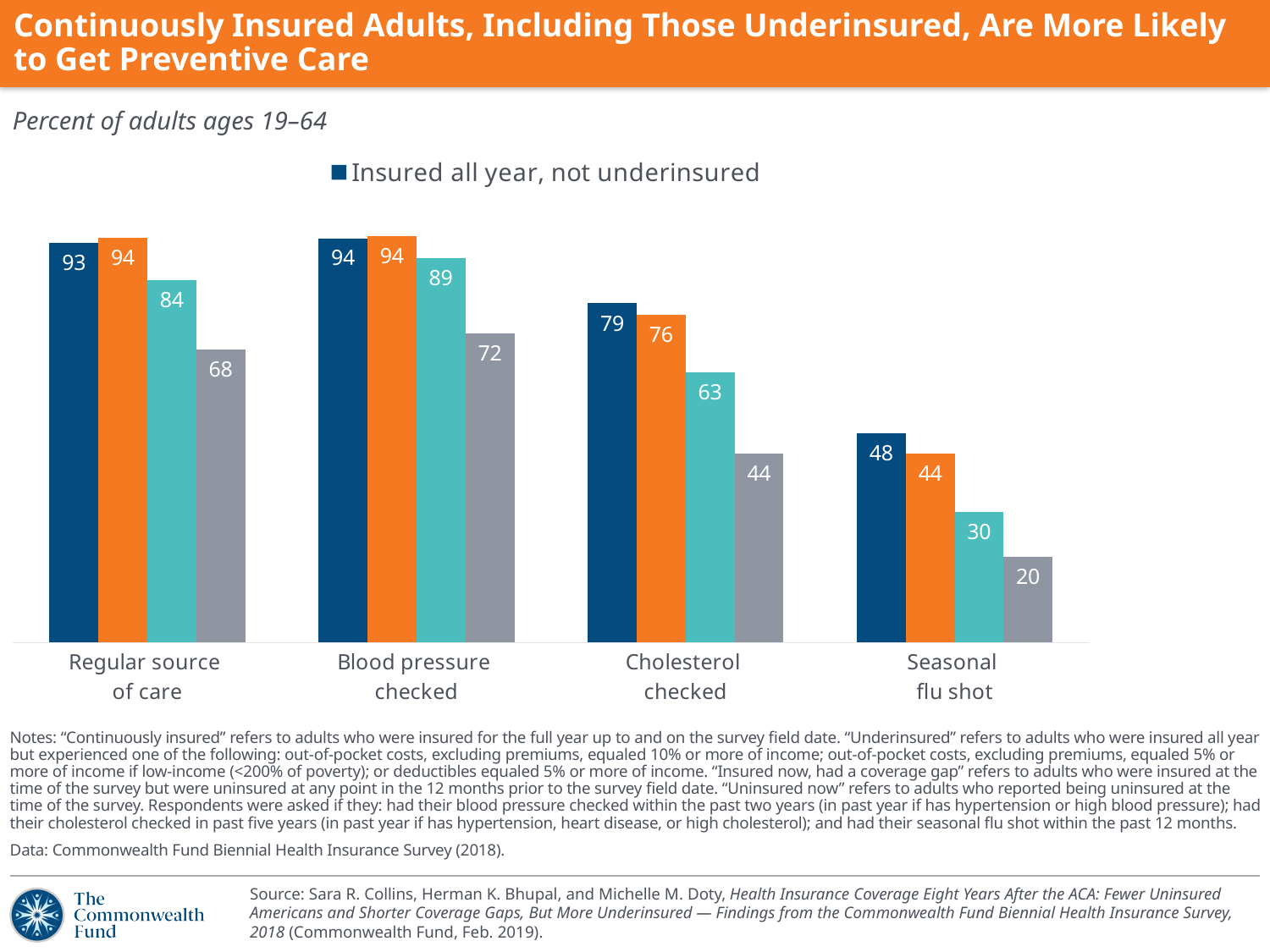
What is the value for 'Insured all year, not underinsured' adults for Seasonal flu shot? 48 What is the value of the gray bar for Cholesterol checked? 44 What is the difference between the 'Insured all year, not underinsured' value and the gray bar value for Seasonal flu shot? 28 How many series does the legend list? 1 What is the value for 'Insured all year, not underinsured' adults for Regular source of care? 93 What is the difference between the orange bar and the teal bar for Cholesterol checked? 13 What is the value of the teal bar for Blood pressure checked? 89 Which is larger for Regular source of care: the 'Insured all year, not underinsured' bar or the orange bar? the orange bar How many categories are shown on the x axis? 4 What kind of chart is shown on the slide? bar chart For the 'Insured all year, not underinsured' series, which category has the highest value? Blood pressure checked For the 'Insured all year, not underinsured' series, which category has the lowest value? Seasonal flu shot